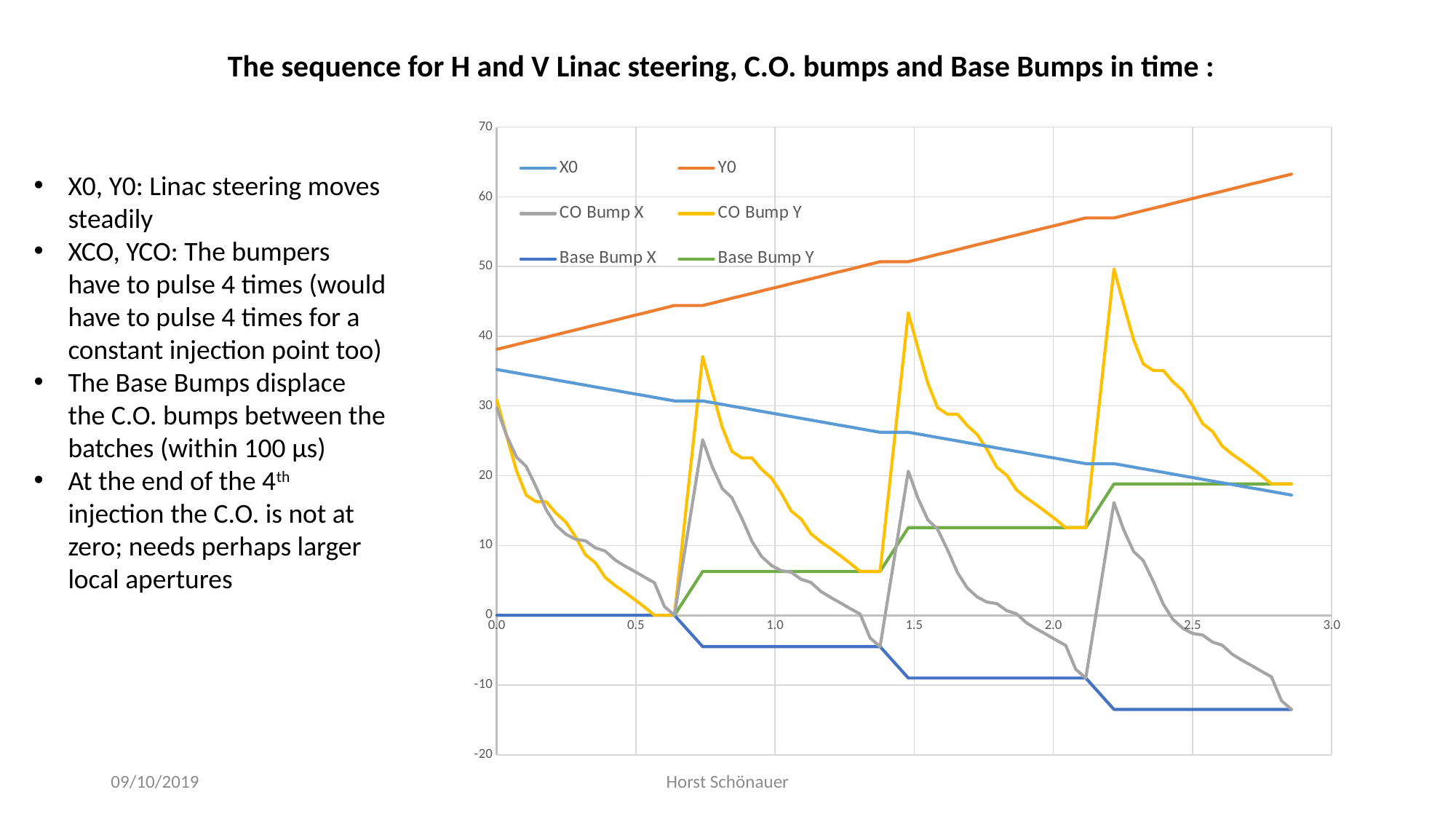
Which series reaches the highest value on the chart? Y0 Is the value of Base Bump X at the right end of the chart greater or less than -10? less Is the value of Y0 at x = 0.0 greater or less than 30? greater What is the title of the slide containing the chart? The sequence for H and V Linac steering, C.O. bumps and Base Bumps in time : How many series does the chart legend list? 6 Is the value of Base Bump Y at the right end of the chart greater or less than 10? greater What kind of chart is shown on the slide? line chart Does the Y0 series rise or fall as the x axis increases? rises At x = 0.0, which is larger, the value of Y0 or the value of X0? Y0 Does the X0 series rise or fall as the x axis increases? falls What colour is the Y0 line in the chart? orange